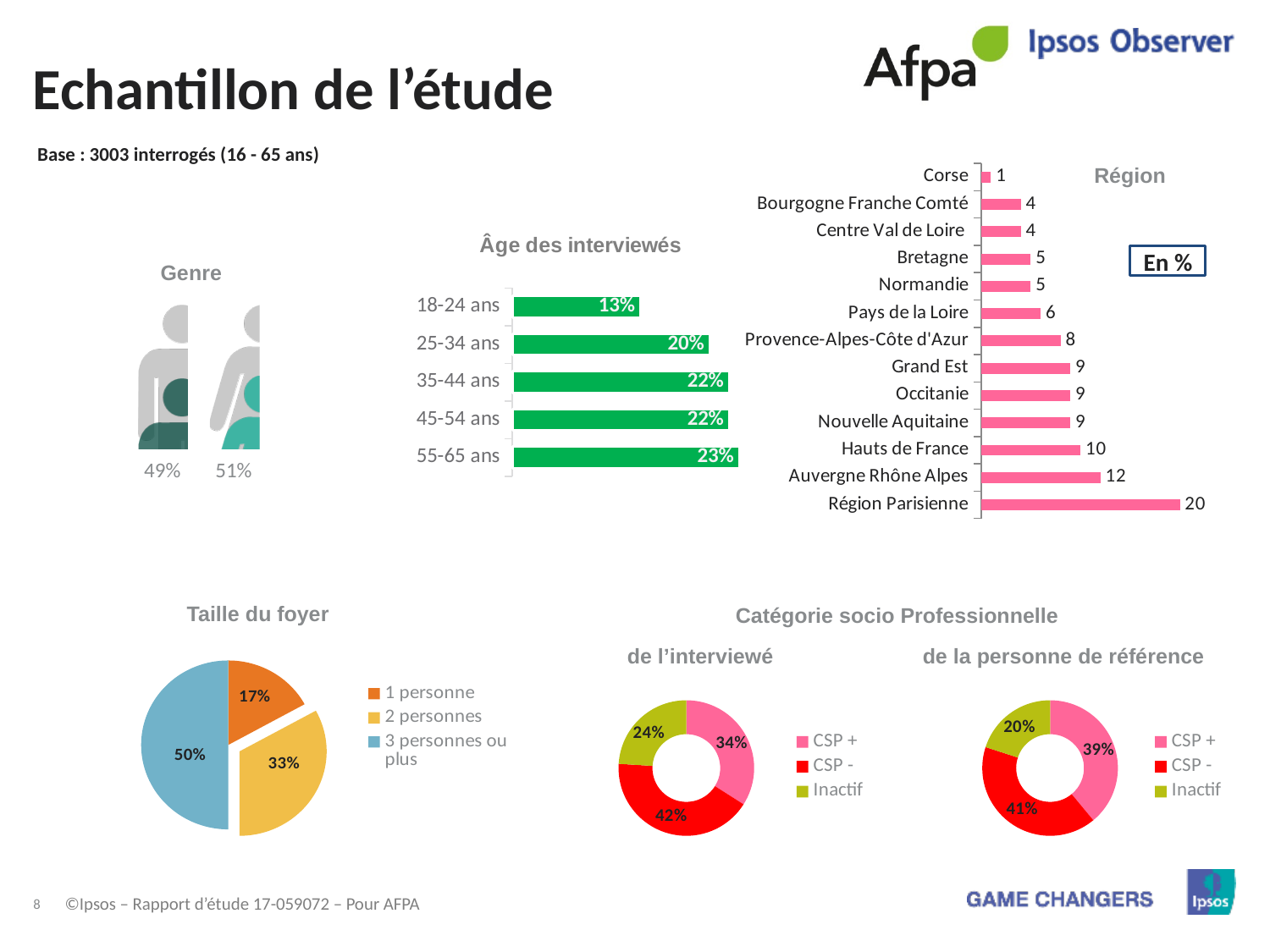
In the 'Âge des interviewés' chart, what is the value for 18-24 ans? 13% In the 'Région' chart, how many regions are listed? 13 In the 'Région' chart, what is the value for Région Parisienne? 20 In the 'Taille du foyer' chart, what share is '3 personnes ou plus'? 50% In the 'Région' chart, which region has the lowest value? Corse In the 'Âge des interviewés' chart, how many age groups are shown? 5 In the 'Région' chart, which is larger, Hauts de France or Bretagne? Hauts de France In the 'Région' chart, what is the difference between Région Parisienne and Auvergne Rhône Alpes? 8 What kind of chart is the 'Taille du foyer' chart? Pie chart In the 'Âge des interviewés' chart, which age group has the highest value? 55-65 ans In the 'Catégorie socio Professionnelle de la personne de référence' chart, how many series does the legend list? 3 In the 'Catégorie socio Professionnelle de l'interviewé' chart, what is the value for CSP -? 42%